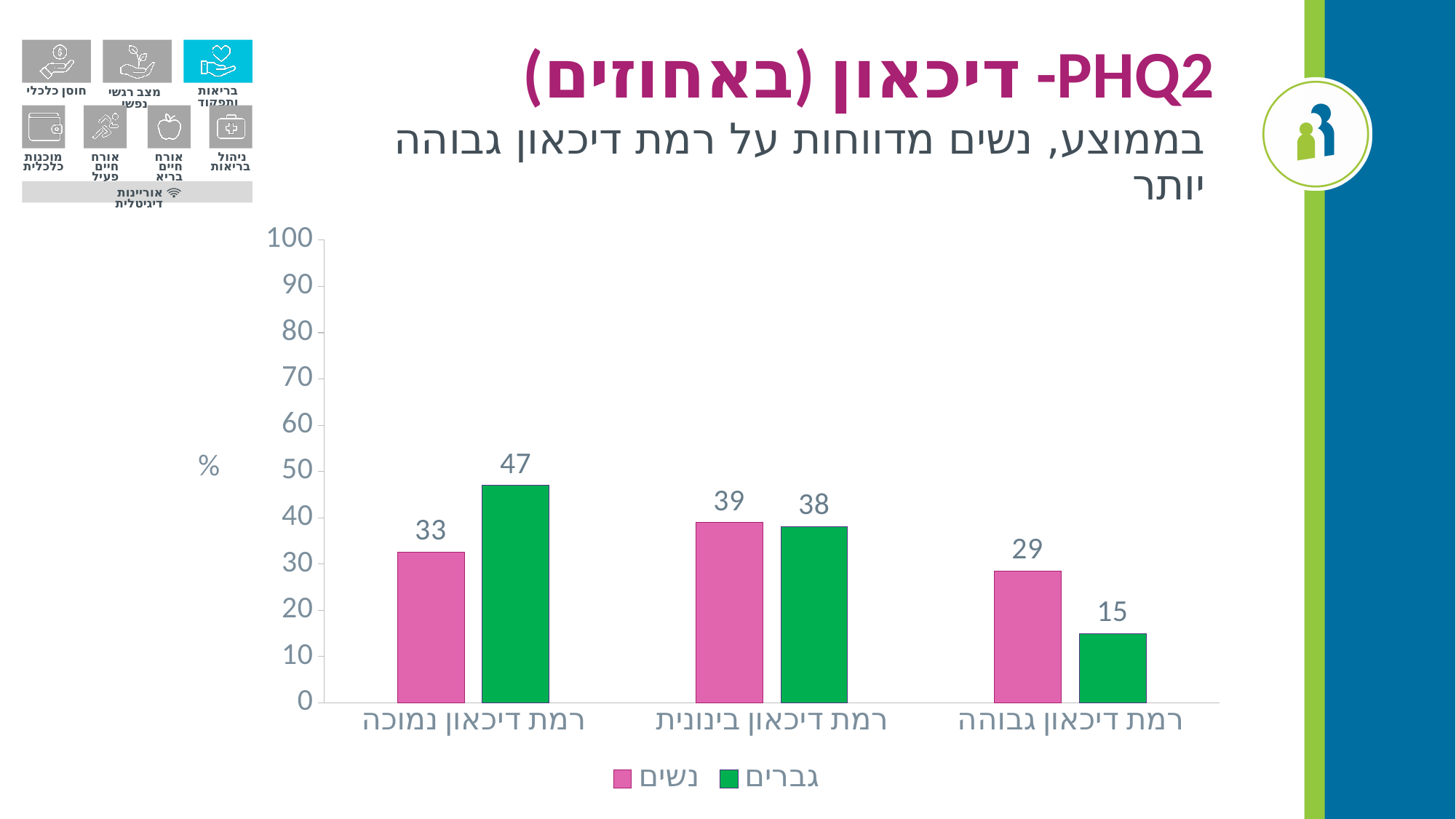
What value is shown for נשים in the רמת דיכאון בינונית category? 39 In which category does the גברים series reach its highest value? רמת דיכאון נמוכה What value is shown for גברים in the רמת דיכאון גבוהה category? 15 In which category does the נשים series have its lowest value? רמת דיכאון גבוהה What kind of chart is shown on the slide? bar chart What value is shown for נשים in the רמת דיכאון נמוכה category? 33 Which colour represents the נשים series? pink What value is shown for גברים in the רמת דיכאון נמוכה category? 47 How many categories are shown on the x axis? 3 In the רמת דיכאון נמוכה category, which series has the larger value, נשים or גברים? גברים How many series does the legend list? 2 What is the difference between the גברים and נשים values in the רמת דיכאון גבוהה category? 14